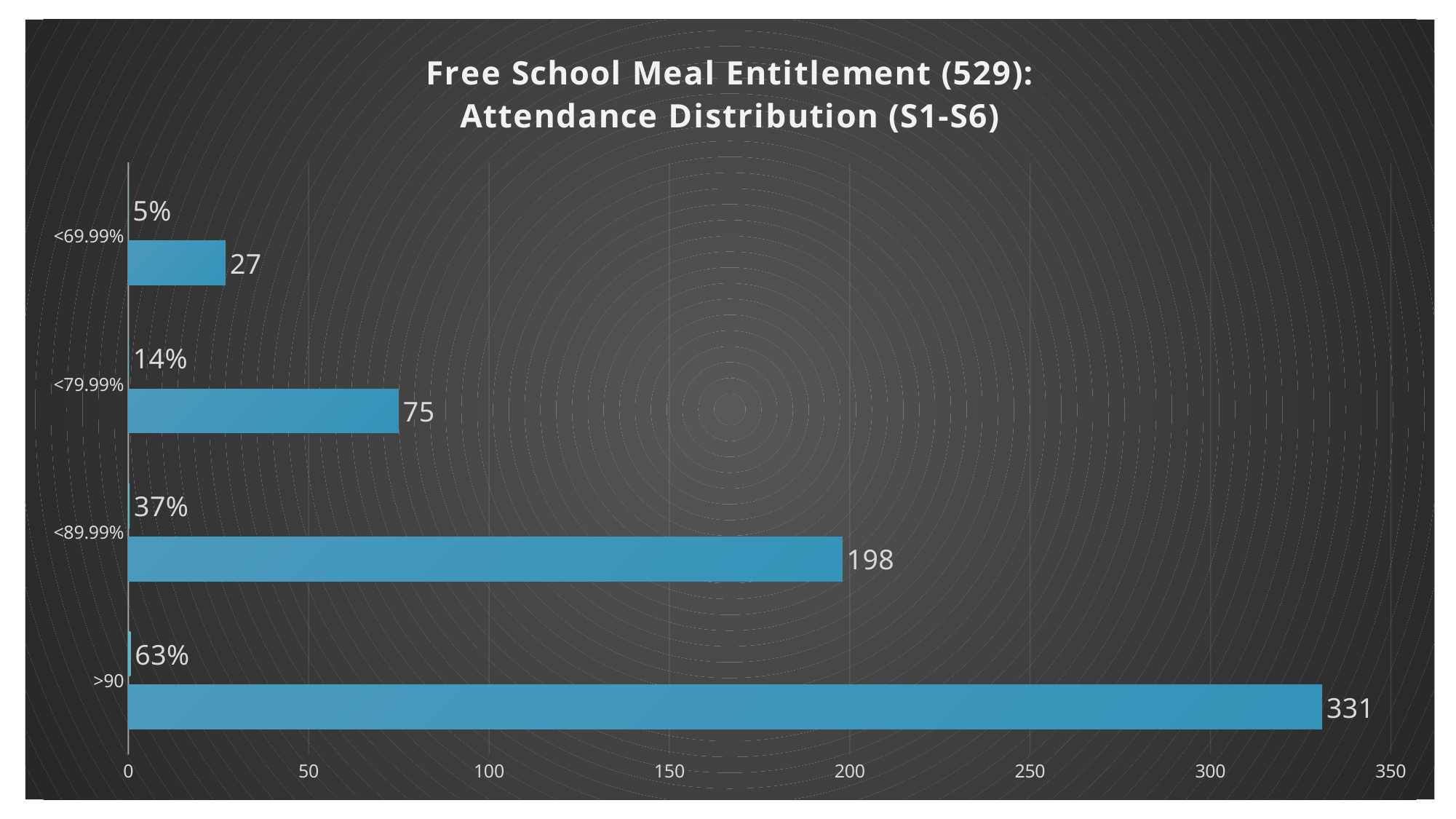
What is the number of pupils in the >90 attendance category? 331 What percentage label is shown for the <69.99% category? 5% How many attendance categories are shown in the chart? 4 What is the title of the chart? Free School Meal Entitlement (529): Attendance Distribution (S1-S6) Which has a larger count, <79.99% or <69.99%? <79.99% What kind of chart is shown on the slide? Bar chart What is the difference between the counts for >90 and <89.99%? 133 What is the number of pupils in the <79.99% attendance category? 75 Which attendance category has the highest count? >90 What percentage label is shown for the <89.99% category? 37% Which attendance category has the lowest count? <69.99% Is the value for <89.99% greater or less than 150? greater